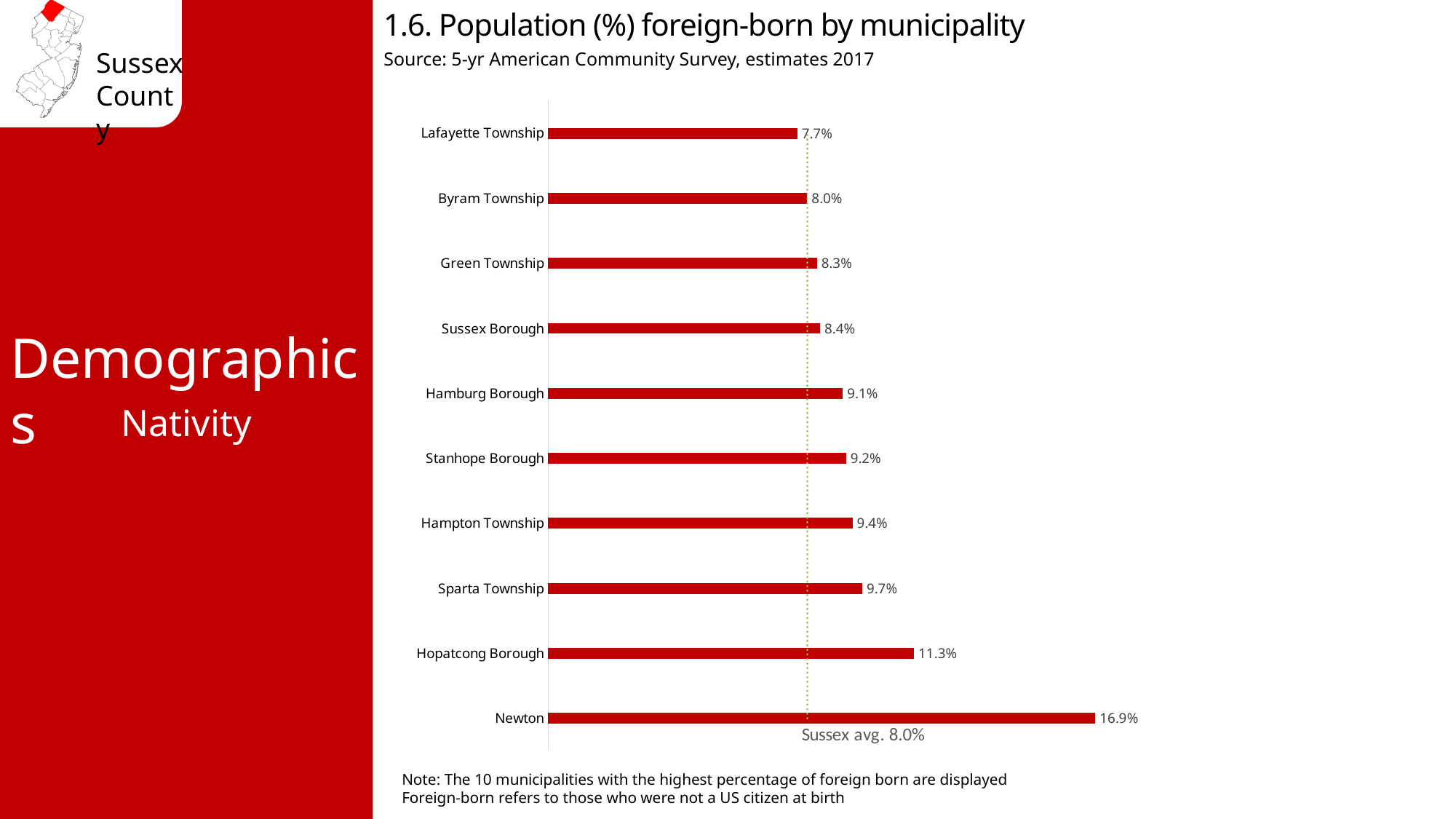
Which municipality has the lowest foreign-born percentage shown? Lafayette Township What is the Sussex County average foreign-born percentage marked by the dotted line? 8.0% What is the foreign-born population percentage for Lafayette Township? 7.7% What is the foreign-born population percentage for Stanhope Borough? 9.2% Which municipality has the highest foreign-born percentage? Newton What kind of chart is used on this slide? Bar chart Which has a higher foreign-born percentage, Sparta Township or Hampton Township? Sparta Township What is the source of the data shown in the chart? 5-yr American Community Survey, estimates 2017 What is the foreign-born population percentage for Hopatcong Borough? 11.3% How many municipalities are shown in the chart? 10 What is the foreign-born population percentage for Newton? 16.9% What is the difference in foreign-born percentage between Newton and Hopatcong Borough? 5.6%